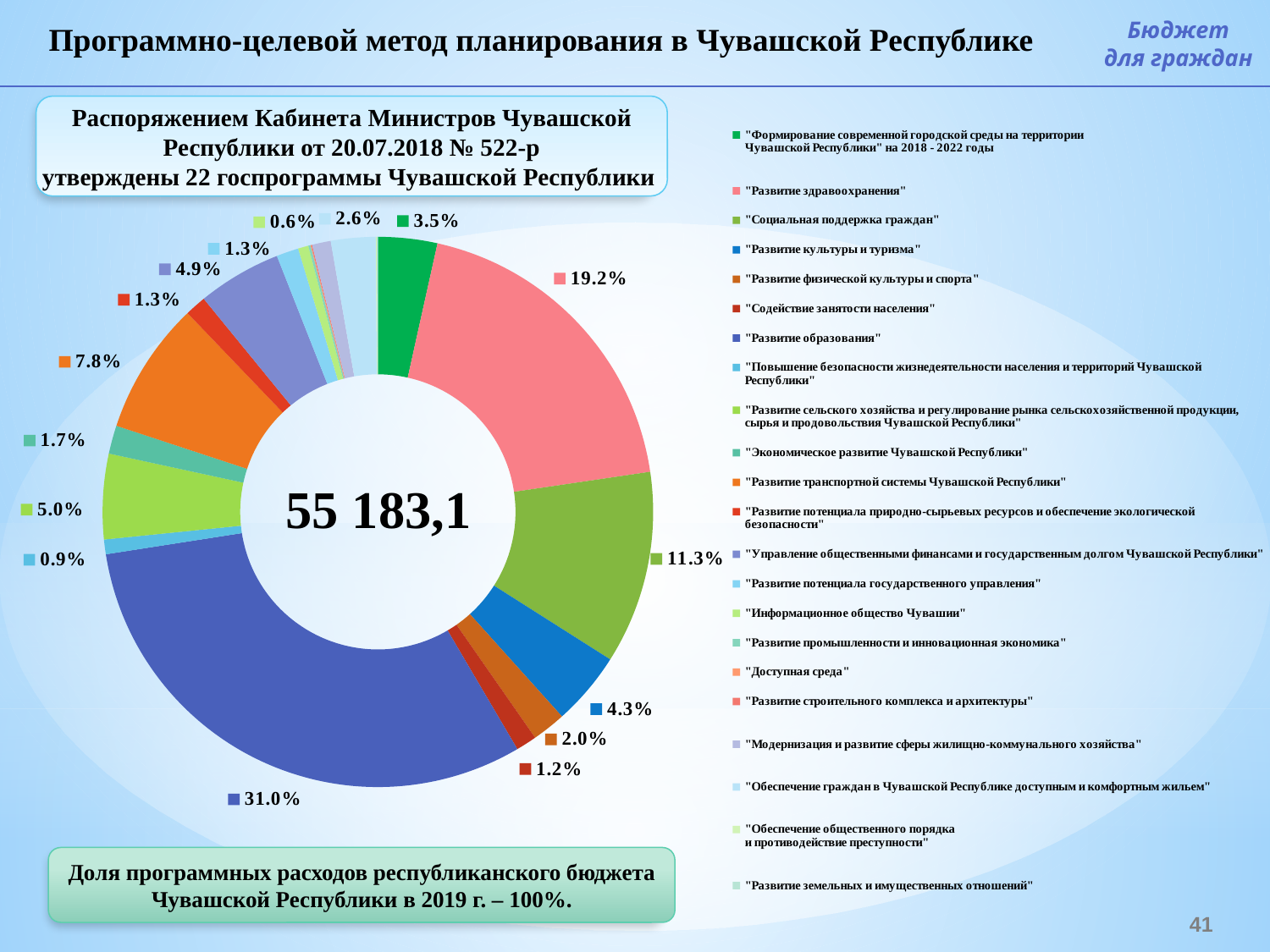
What share does "Развитие здравоохранения" have in the chart? 19.2% What share does "Развитие культуры и туризма" have in the chart? 4.3% What share does "Развитие сельского хозяйства и регулирование рынка сельскохозяйственной продукции, сырья и продовольствия Чувашской Республики" have? 5.0% What kind of chart is shown on the slide? doughnut (pie) chart What share does "Формирование современной городской среды на территории Чувашской Республики" на 2018 - 2022 годы have in the chart? 3.5% What share does "Развитие транспортной системы Чувашской Республики" have in the chart? 7.8% Which programme has the largest share in the chart? "Развитие образования" (31.0%) What is the difference in percentage points between the shares of "Развитие образования" and "Развитие здравоохранения"? 11.8 percentage points What share does "Социальная поддержка граждан" have in the chart? 11.3% How many state programmes (categories) does the chart represent? 22 Which has a larger share: "Управление общественными финансами и государственным долгом Чувашской Республики" or "Развитие культуры и туризма"? "Управление общественными финансами и государственным долгом Чувашской Республики" (4.9%) What value is printed in the centre of the doughnut chart? 55 183,1